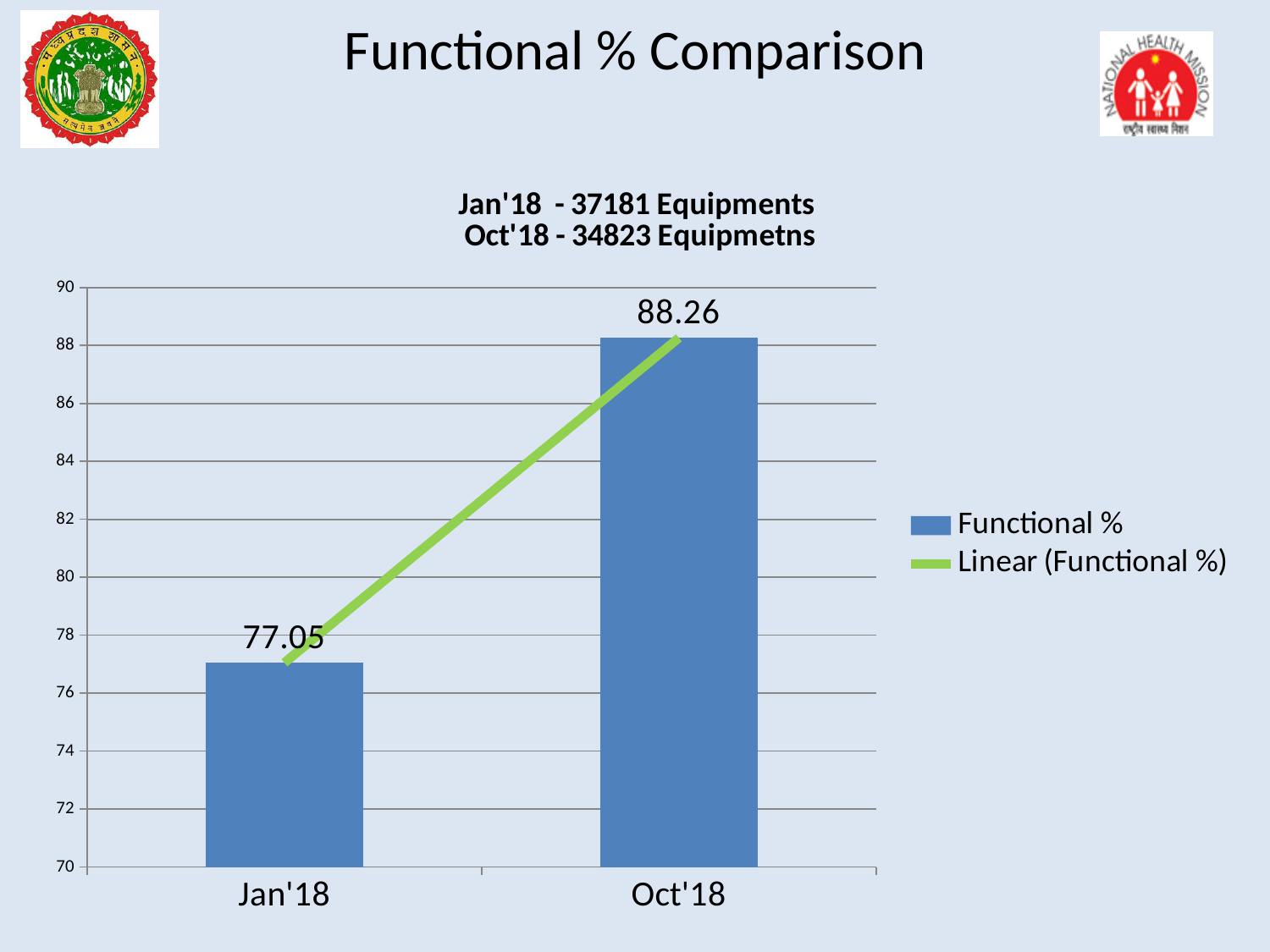
Is the Functional % value for Jan'18 larger or smaller than the value for Oct'18? smaller Which category has the higher Functional % value? Oct'18 Is the Functional % value for Oct'18 greater or less than 86? greater What is the Functional % value for Oct'18? 88.26 Is the Functional % value for Jan'18 greater or less than 80? less What kind of chart is shown on the slide? bar chart What is the Functional % value for Jan'18? 77.05 How many categories are shown on the x axis? 2 What is the difference between the Functional % values for Oct'18 and Jan'18? 11.21 How many entries does the legend list? 2 Which category has the lower Functional % value? Jan'18 Does the Functional % value rise or fall from Jan'18 to Oct'18? rise